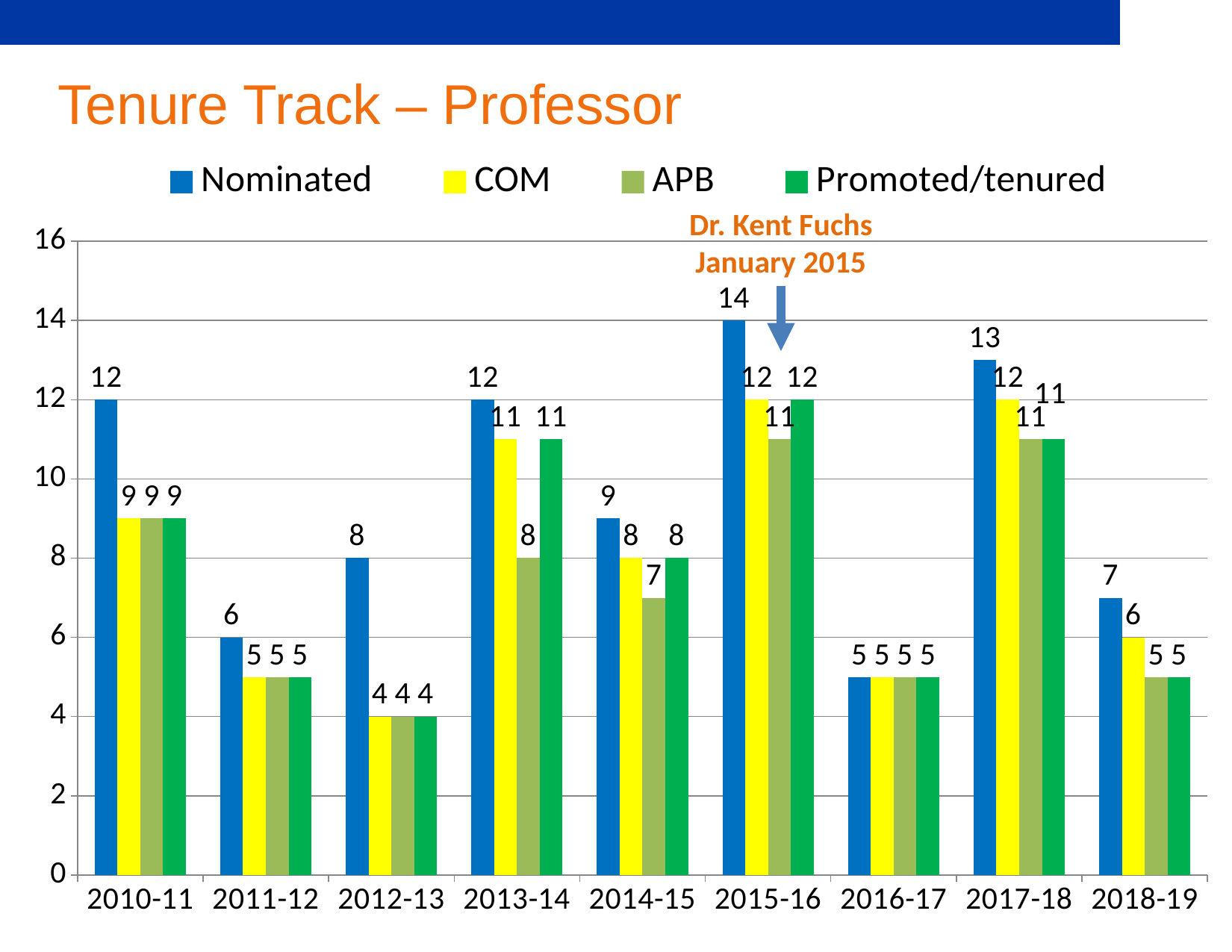
What name and date appear in the annotation above the 2015-16 bars? Dr. Kent Fuchs, January 2015 What is the difference between the Nominated and Promoted/tenured values for 2012-13? 4 What kind of chart is shown on the slide? Bar chart How many academic years are shown on the x axis? 9 Which is larger, the Nominated value for 2017-18 or the Nominated value for 2013-14? 2017-18 Which year has the highest Nominated value? 2015-16 Which year has the lowest Promoted/tenured value? 2012-13 What is the COM value for 2018-19? 6 What is the APB value for 2013-14? 8 How many series does the legend list? 4 What is the Nominated value for 2015-16? 14 What is the Promoted/tenured value for 2012-13? 4